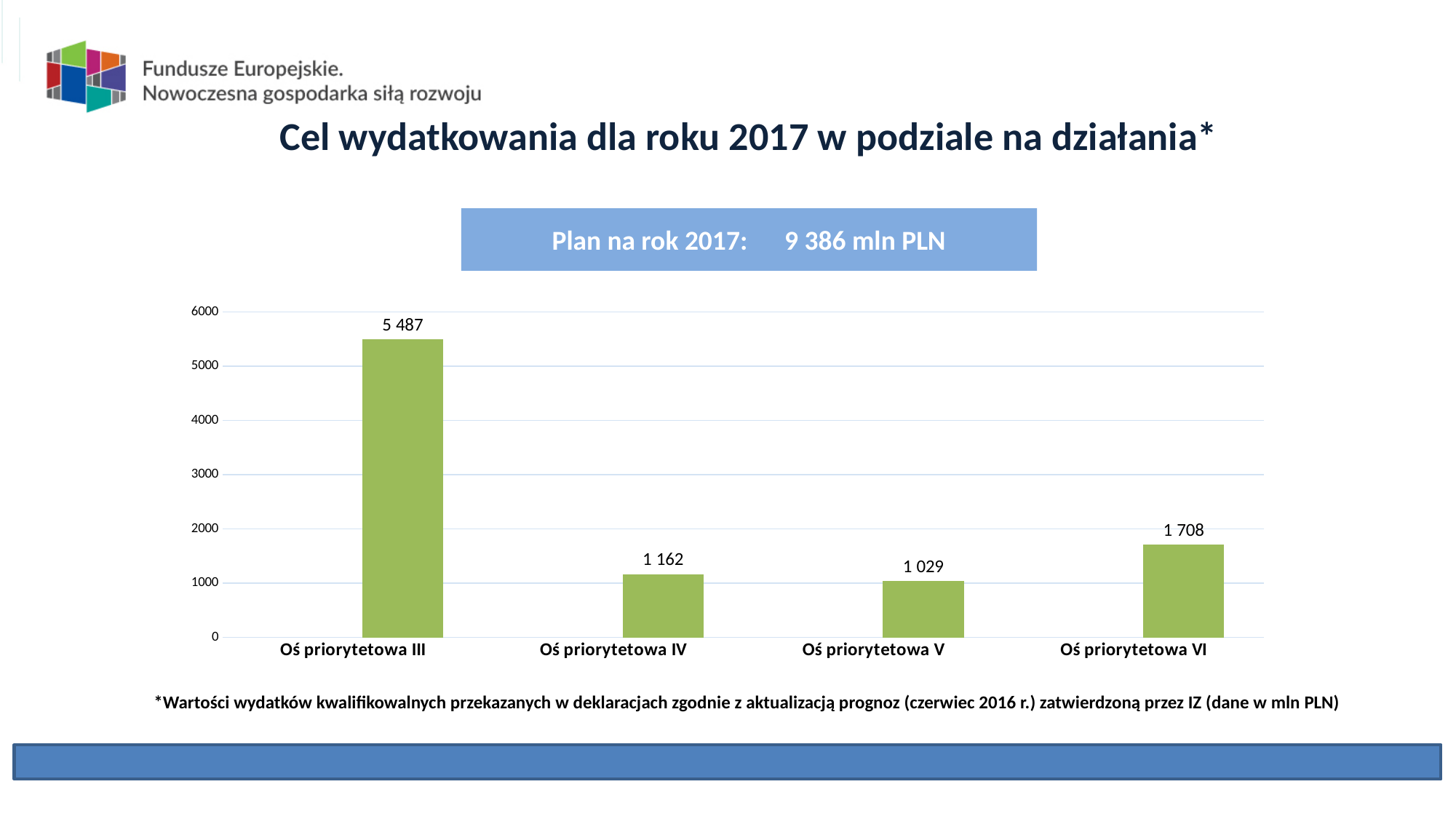
What is the value for Oś priorytetowa IV? 1 162 Which category has the lowest value? Oś priorytetowa V Which category has the highest value? Oś priorytetowa III What is the difference between the values for Oś priorytetowa IV and Oś priorytetowa V? 133 What is the value for Oś priorytetowa V? 1 029 What is the difference between the values for Oś priorytetowa III and Oś priorytetowa VI? 3 779 Which is larger, the value for Oś priorytetowa VI or the value for Oś priorytetowa IV? Oś priorytetowa VI What is the value for Oś priorytetowa VI? 1 708 How many categories are shown on the x axis? 4 What is the value for Oś priorytetowa III? 5 487 What is the plan for 2017 stated in the box above the chart? 9 386 mln PLN What kind of chart is shown on the slide? bar chart